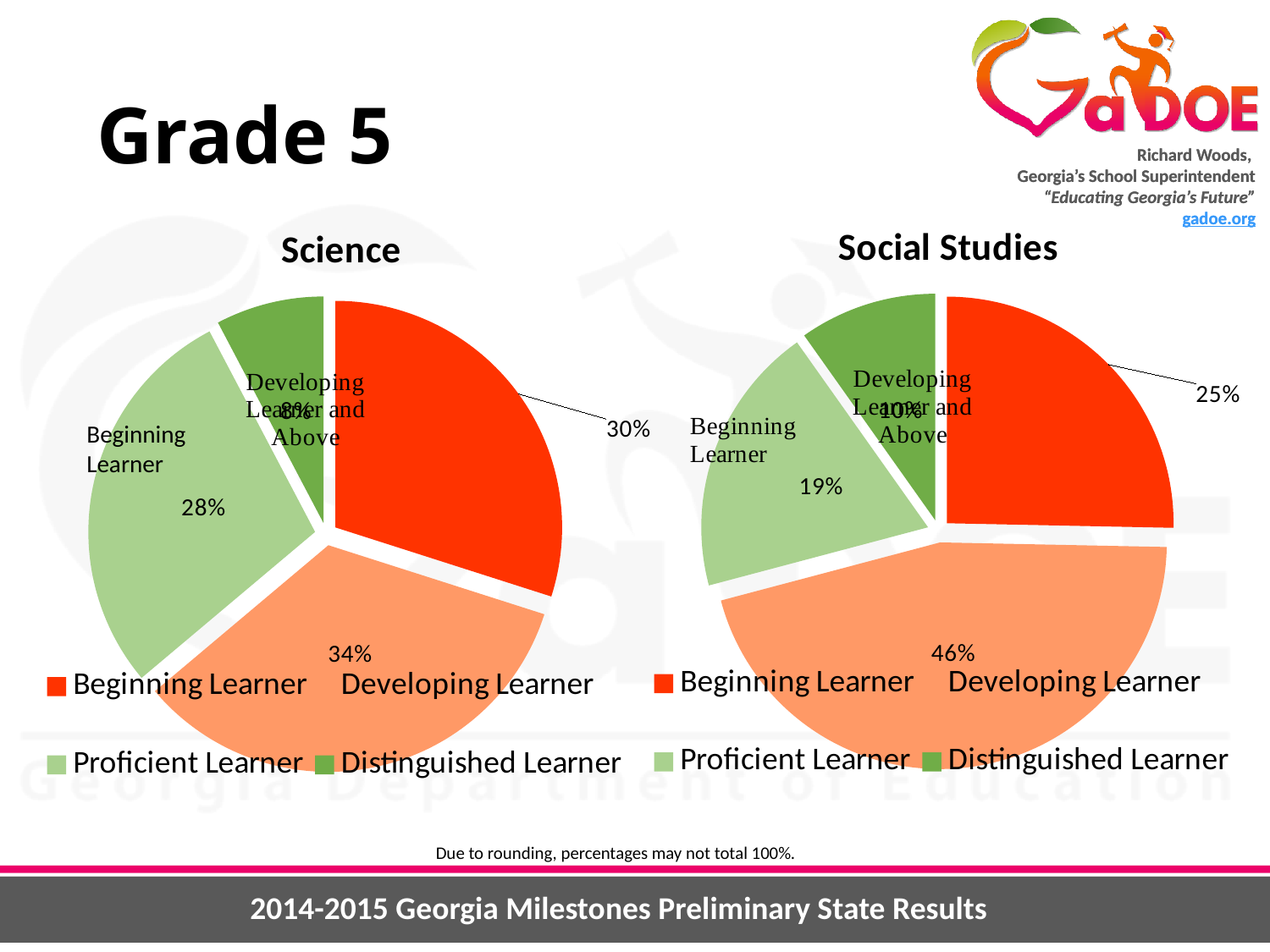
In the Science pie chart, how many percentage points larger is the Developing Learner share than the Beginning Learner share? 4 percentage points In the Social Studies pie chart, what percentage of students are Developing Learners? 46% In the Science pie chart, what percentage of students are Developing Learners? 34% In the Social Studies pie chart, what percentage of students are Beginning Learners? 25% In the Social Studies pie chart, which category has the smallest share? Distinguished Learner In the Science pie chart, which category has the largest share? Developing Learner In the Social Studies pie chart, which is larger: the Beginning Learner share or the Proficient Learner share? Beginning Learner What type of chart is used for the Science results? Pie chart In the Social Studies pie chart, what percentage of students are Proficient Learners? 19% In the Science pie chart, what percentage of students are Beginning Learners? 30% How many categories does the legend of the Social Studies pie chart list? 4 In the Science pie chart, what percentage of students are Proficient Learners? 28%